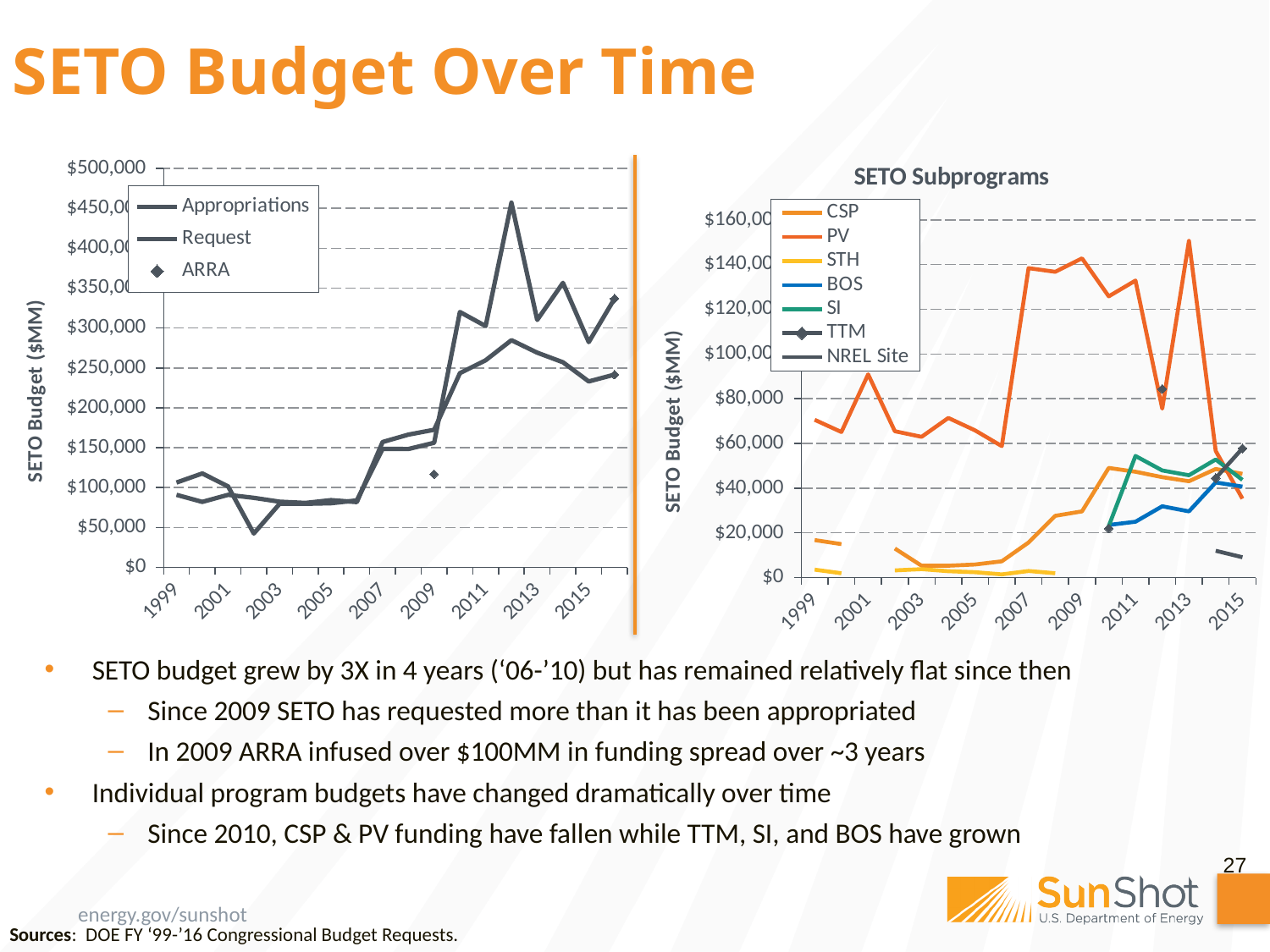
In the left chart, which series is higher in 2012, Appropriations or Request? Request How many series does the legend of the SETO Subprograms chart list? 7 What kind of chart is the left chart on the slide? line chart In the SETO Subprograms chart, which series has the highest value in 2008? PV In the left chart, is the Appropriations value for 2002 greater or less than $100,000? less In the left chart, which year has the highest Request value? 2012 In the left chart, is the Request value for 2012 greater or less than $400,000? greater In the SETO Subprograms chart, is the PV value for 2013 greater or less than $140,000? greater In the SETO Subprograms chart, do the PV values rise or fall from 2013 to 2015? fall How many series does the legend of the left chart list? 3 What is the title of the right chart? SETO Subprograms In the left chart, do the Appropriations values rise or fall from 2006 to 2010? rise